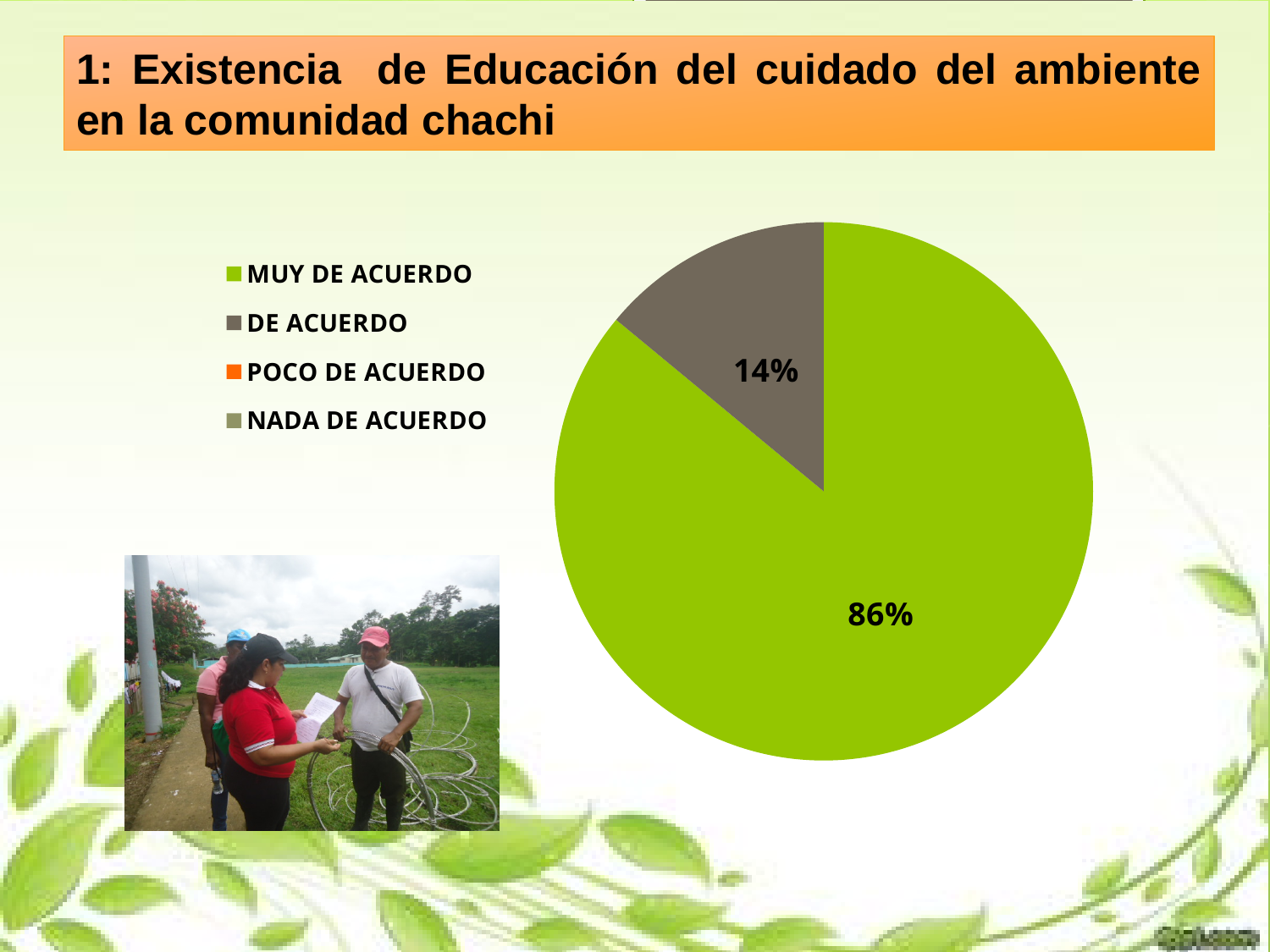
How many slices with data labels are visible in the pie? 2 Is the share for DE ACUERDO greater or less than 50%? less Which of the two visible slices is smaller, MUY DE ACUERDO or DE ACUERDO? DE ACUERDO What kind of chart is shown on the slide? pie chart What colour is the slice labelled 86%? green Which legend entry is shown with a grey marker? DE ACUERDO What percentage of the pie corresponds to DE ACUERDO? 14% Which category has the largest share of the pie? MUY DE ACUERDO What percentage of the pie corresponds to MUY DE ACUERDO? 86% What is the difference in percentage points between the MUY DE ACUERDO slice and the DE ACUERDO slice? 72 How many entries does the legend list? 4 Which is larger, the share for MUY DE ACUERDO or the share for DE ACUERDO? MUY DE ACUERDO